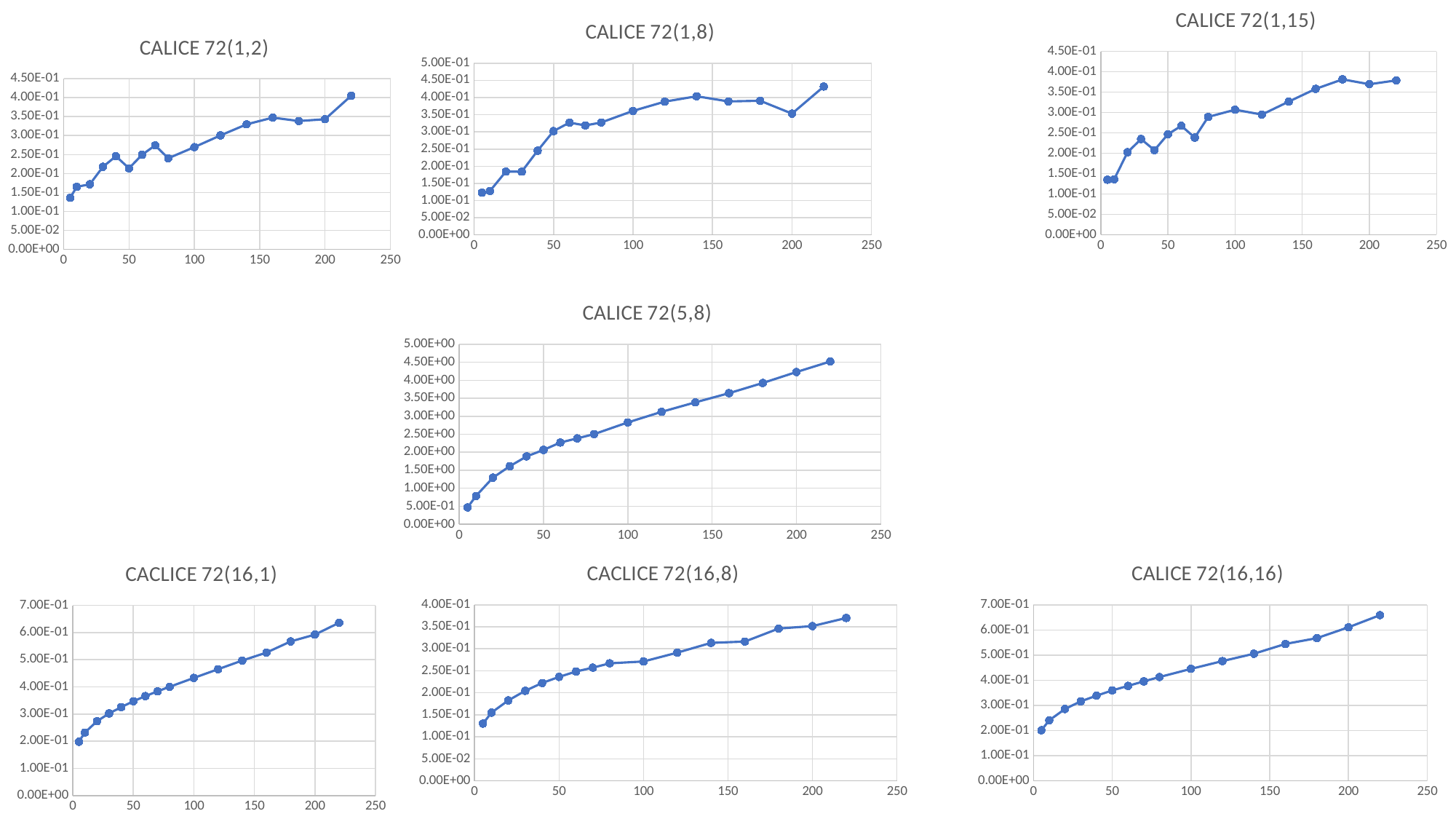
In the CACLICE 72(16,8) chart, is the value at x = 5 greater or less than 1.50E-01? less What is the title of the chart in the middle of the slide? CALICE 72(5,8) In the CALICE 72(1,8) chart, which x value has the highest plotted value? 220 In the CALICE 72(5,8) chart, do the values rise or fall as x increases? rise In the CALICE 72(5,8) chart, is the value at x = 220 greater or less than 4.00E+00? greater What kind of chart is CALICE 72(5,8)? line chart How many charts are shown on the slide? 7 In the CALICE 72(1,2) chart, which x value has the lowest plotted value? 5 How many data points are plotted in the CALICE 72(5,8) chart? 16 In the CALICE 72(1,8) chart, which is larger: the value at x = 140 or the value at x = 200? x = 140 In the CALICE 72(1,8) chart, is the value at x = 220 greater or less than 4.00E-01? greater